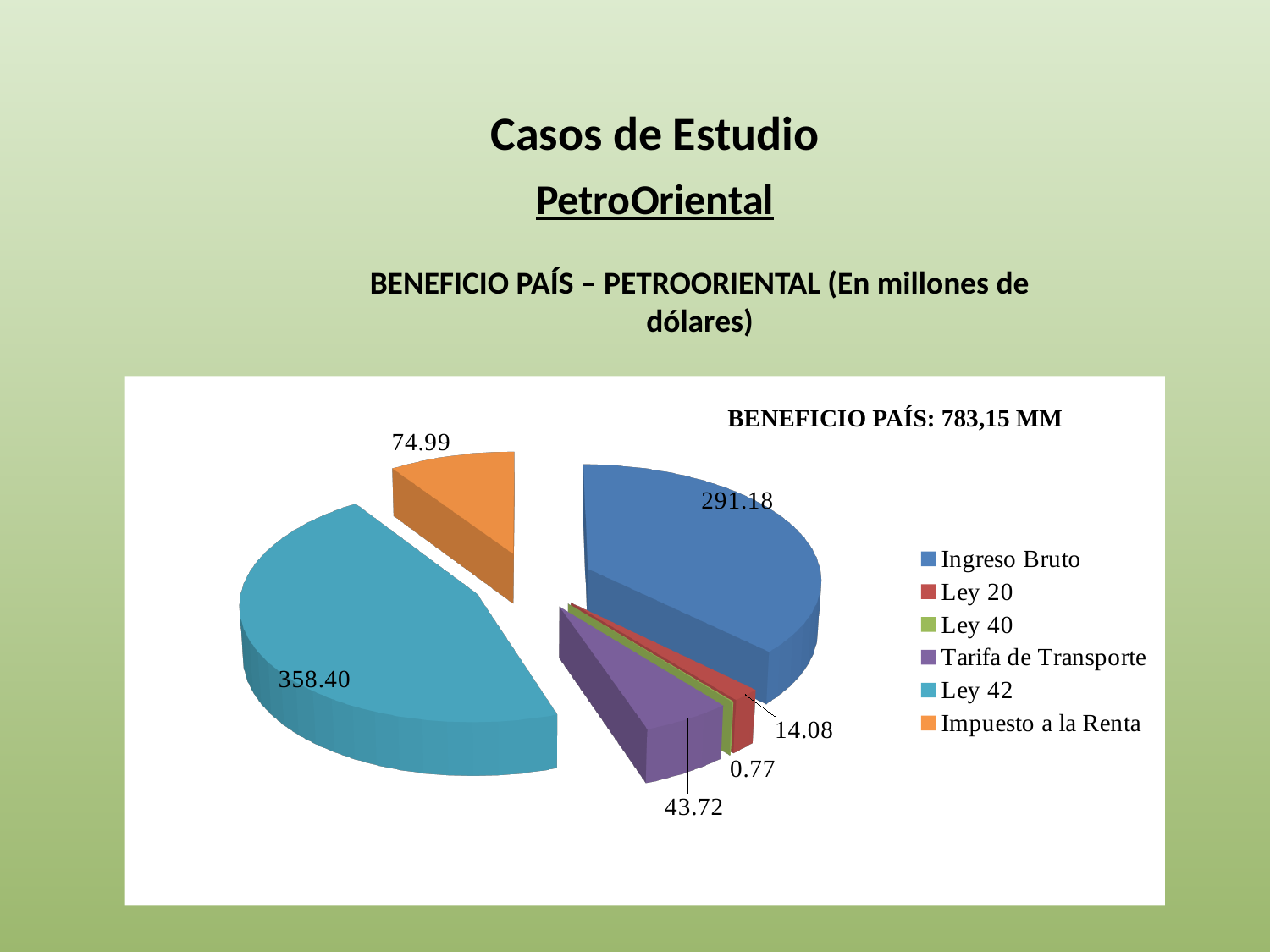
Which category has the smallest slice of the pie? Ley 40 What is the value for Ingreso Bruto? 291.18 What is the difference between the values for Ley 42 and Ingreso Bruto? 67.22 What is the value for Tarifa de Transporte? 43.72 What is the value for Impuesto a la Renta? 74.99 Which category has the largest slice of the pie? Ley 42 What is the value for Ley 42? 358.40 How many categories does the pie chart show? 6 What is the value for Ley 20? 14.08 What is the value for Ley 40? 0.77 Which is larger, Tarifa de Transporte or Impuesto a la Renta? Impuesto a la Renta What kind of chart is shown on the slide? pie chart